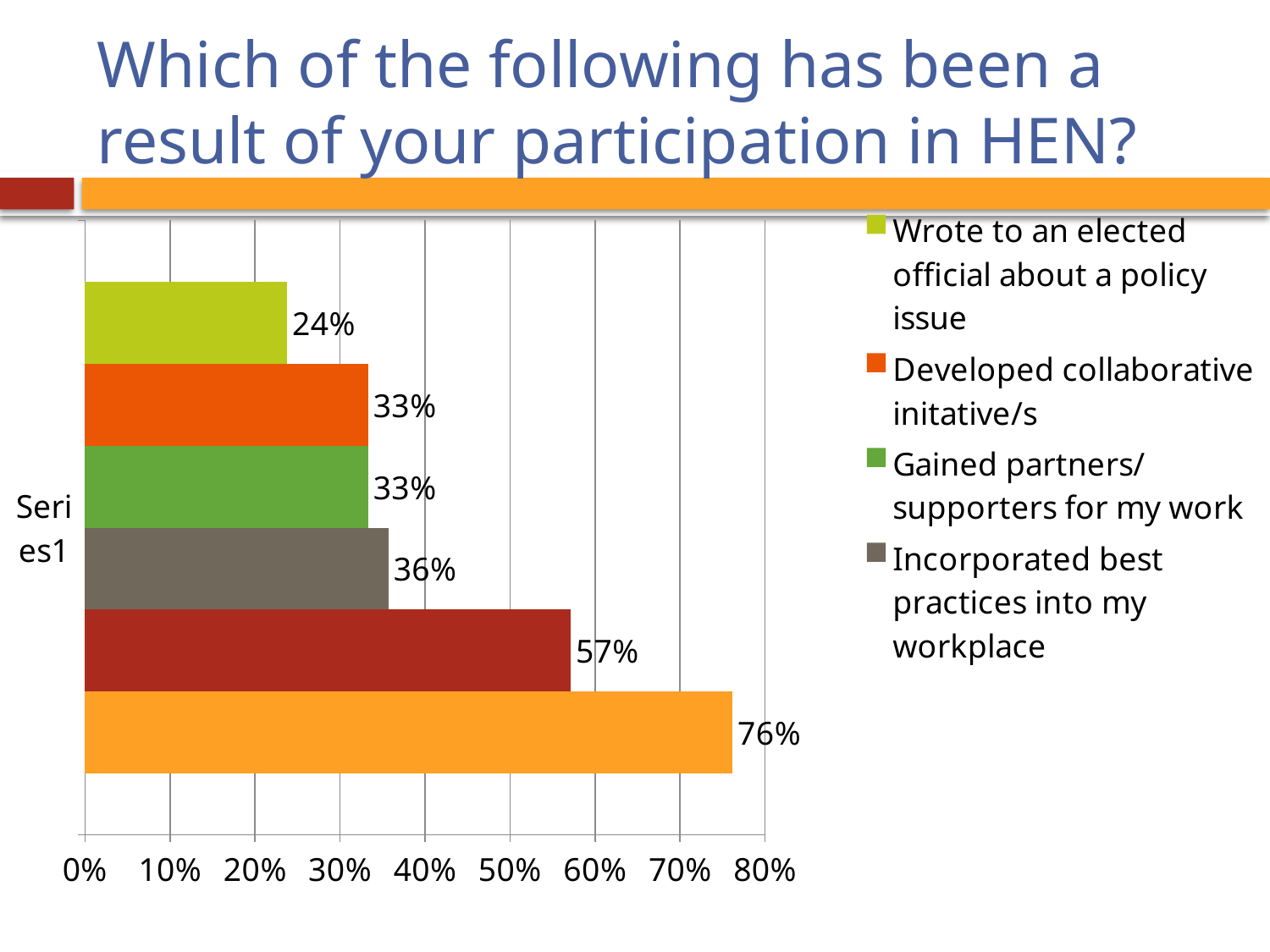
What is the largest value labelled on any bar in the chart? 76% What type of chart is shown on the slide? Bar chart Which legend category has the lowest value? Wrote to an elected official about a policy issue What percentage is shown for "Incorporated best practices into my workplace"? 36% What percentage is shown for "Wrote to an elected official about a policy issue"? 24% What percentage is shown for "Developed collaborative initative/s"? 33% Which is larger: "Incorporated best practices into my workplace" or "Gained partners/supporters for my work"? Incorporated best practices into my workplace How many bars are plotted in the chart? 6 What is the difference between the two largest bar values, 76% and 57%? 19 percentage points How many percentage points higher is "Incorporated best practices into my workplace" than "Wrote to an elected official about a policy issue"? 12 percentage points What percentage is shown for "Gained partners/supporters for my work"? 33% What is the value labelled on the dark red bar? 57%